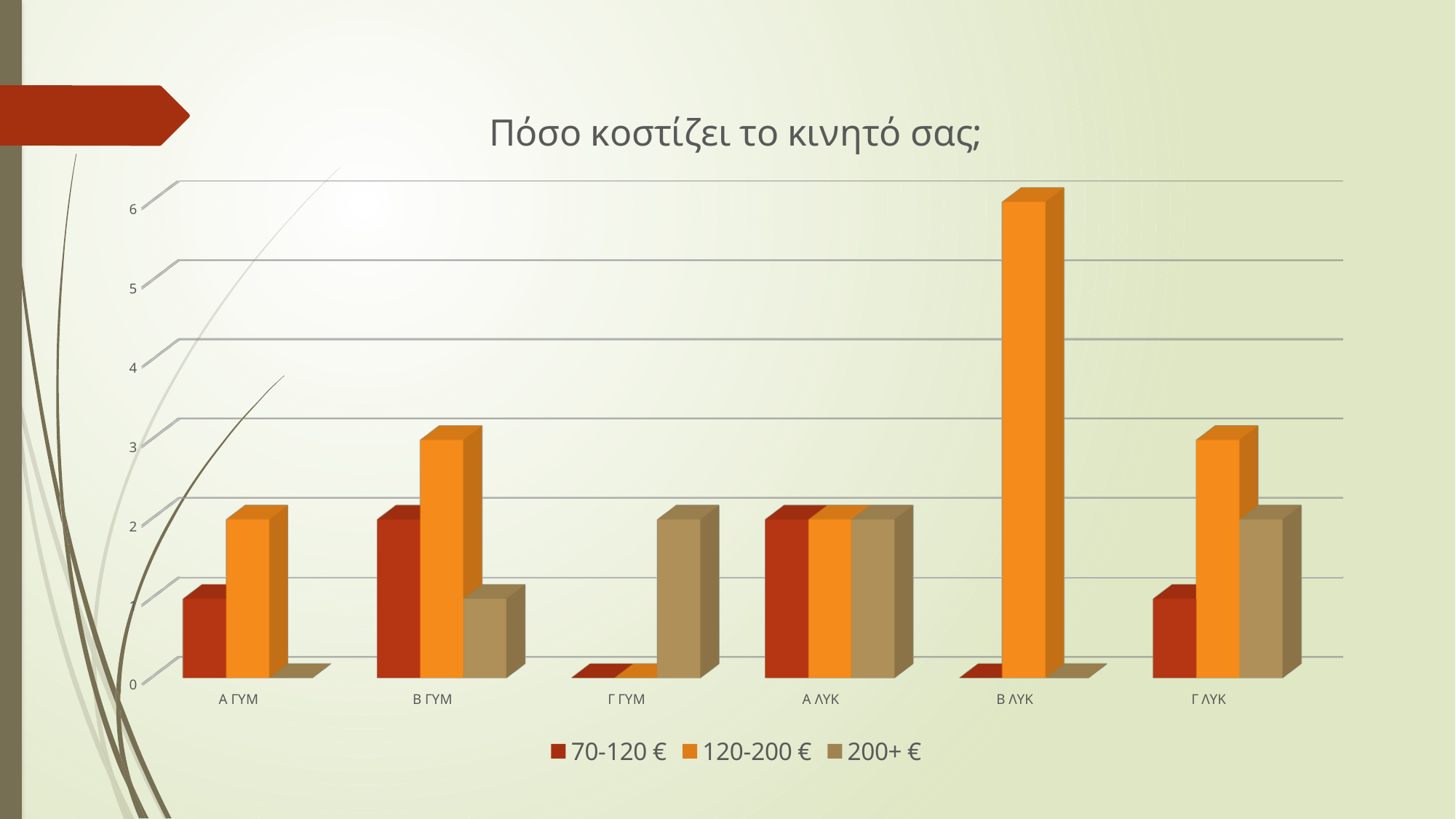
Is the value for the 200+ € series in Β ΓΥΜ greater or less than 2? less Which category has the highest value for the 120-200 € series? Β ΛΥΚ Which is larger in Γ ΓΥΜ: the 70-120 € series or the 200+ € series? 200+ € Is the value for the 120-200 € series in Β ΛΥΚ greater or less than 5? greater How many categories are shown on the x axis? 6 Which is larger in Α ΓΥΜ: the 70-120 € series or the 120-200 € series? 120-200 € How many series does the legend list? 3 What is the value for the 120-200 € series in Β ΓΥΜ? 3 What is the value for the 120-200 € series in Β ΛΥΚ? 6 What is the title of the chart? Πόσο κοστίζει το κινητό σας; What kind of chart is shown on the slide? bar chart Which legend entry is shown in the darkest red colour? 70-120 €